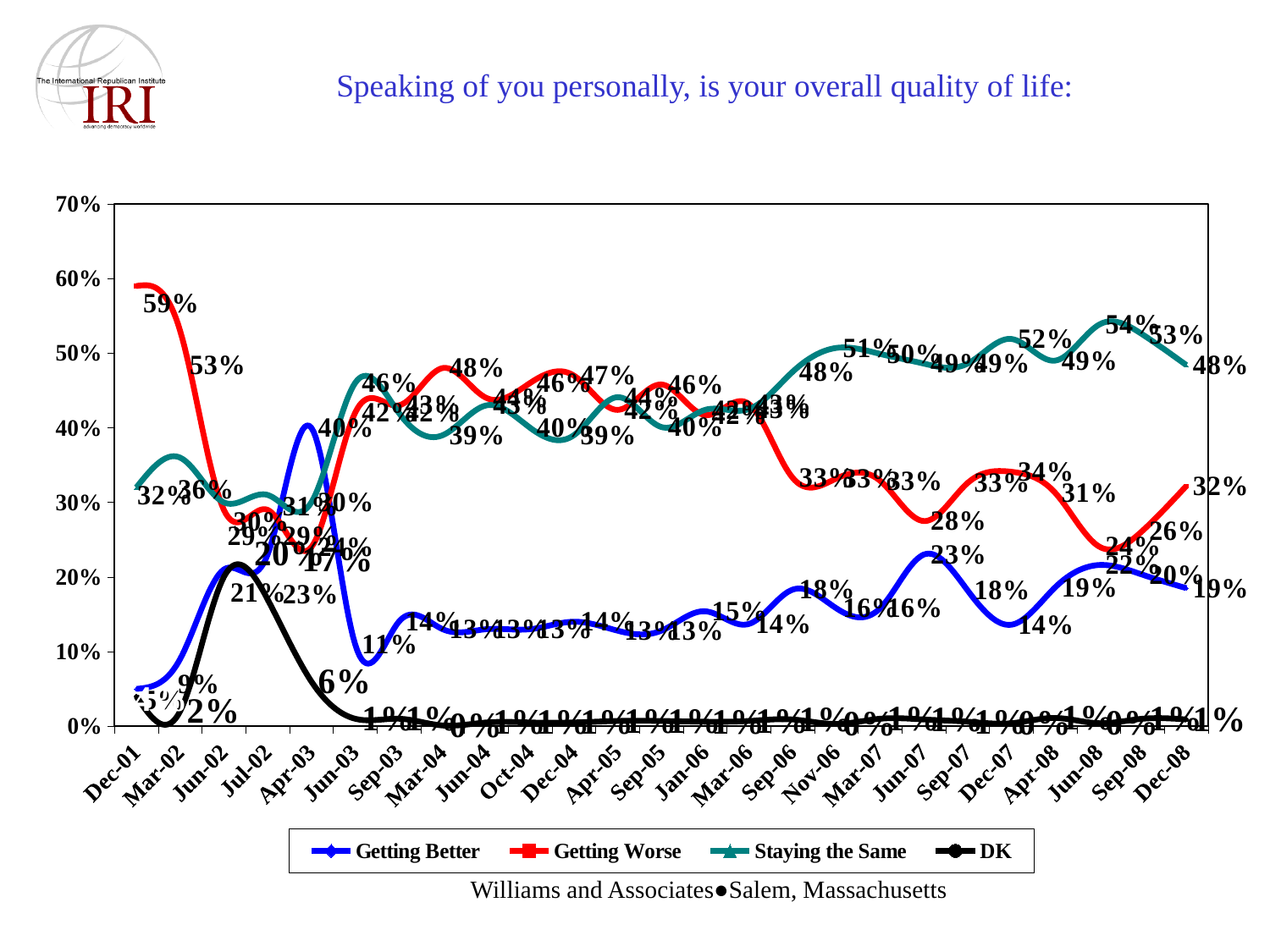
What is the value for Getting Worse at Dec-01? 59% What is the value for Staying the Same at Dec-08? 48% What kind of chart is shown on the slide? line chart Does the Getting Worse line rise or fall from Dec-01 to Mar-02? fall At Dec-08, how much higher is Staying the Same than Getting Worse? 16 percentage points What is the value for Getting Better at Dec-08? 19% What is the value for Getting Worse at Dec-08? 32% At Dec-01, which is larger: Getting Worse or Staying the Same? Getting Worse How many series does the legend list? 4 What is the value for Getting Worse at Mar-02? 53% Which series has the lowest value at Dec-08? DK Which series has the highest value at Dec-08? Staying the Same